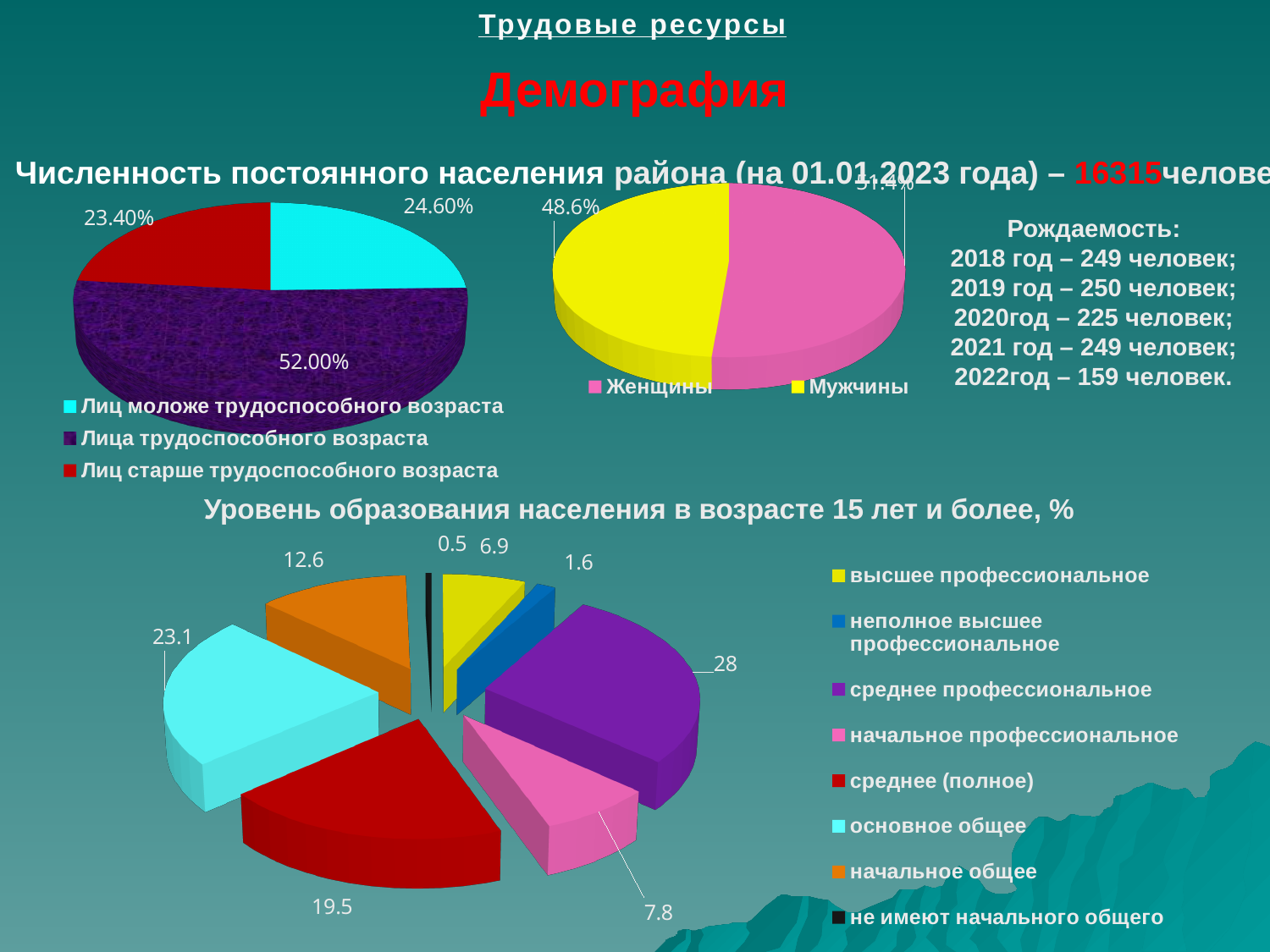
In the bottom chart 'Уровень образования населения в возрасте 15 лет и более, %', what is the value for 'основное общее'? 23.1 In the top-left pie chart on age groups, what is the difference between 'Лиц моложе трудоспособного возраста' and 'Лиц старше трудоспособного возраста'? 1.20% What kind of chart is the bottom chart titled 'Уровень образования населения в возрасте 15 лет и более, %'? pie chart In the bottom chart 'Уровень образования населения в возрасте 15 лет и более, %', which category has the smallest share? не имеют начального общего In the top-left pie chart on age groups, which category has the largest share? Лица трудоспособного возраста In the top-left pie chart on age groups, what is the share for 'Лица трудоспособного возраста'? 52.00% In the bottom chart 'Уровень образования населения в возрасте 15 лет и более, %', what is the value for 'среднее (полное)'? 19.5 In the bottom chart 'Уровень образования населения в возрасте 15 лет и более, %', what is the difference between 'среднее профессиональное' and 'основное общее'? 4.9 In the bottom chart 'Уровень образования населения в возрасте 15 лет и более, %', how many categories does the legend list? 8 In the bottom chart 'Уровень образования населения в возрасте 15 лет и более, %', which category has the largest share? среднее профессиональное In the top-middle pie chart on gender, what is the share for 'Мужчины'? 48.6% In the bottom chart 'Уровень образования населения в возрасте 15 лет и более, %', which is larger: 'начальное общее' or 'начальное профессиональное'? начальное общее